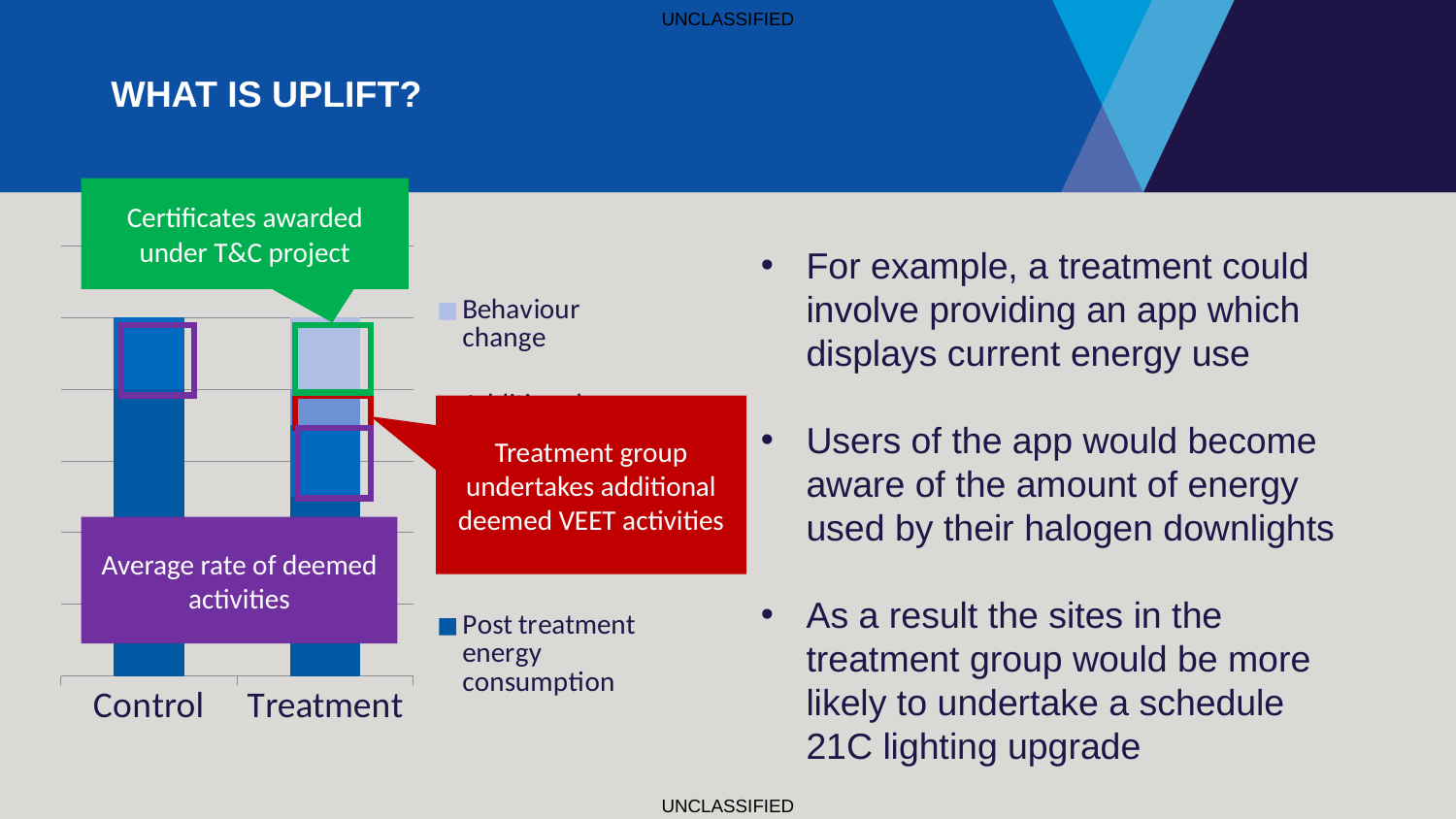
Which legend entry is shown in dark blue? Post treatment energy consumption Which category's bar is made up of more stacked segments, Control or Treatment? Treatment How many categories are shown on the x axis of the chart? 2 What kind of chart is shown on the left of the slide? bar chart What are the two categories on the x axis of the chart? Control and Treatment Which category's bar includes a 'Behaviour change' segment? Treatment